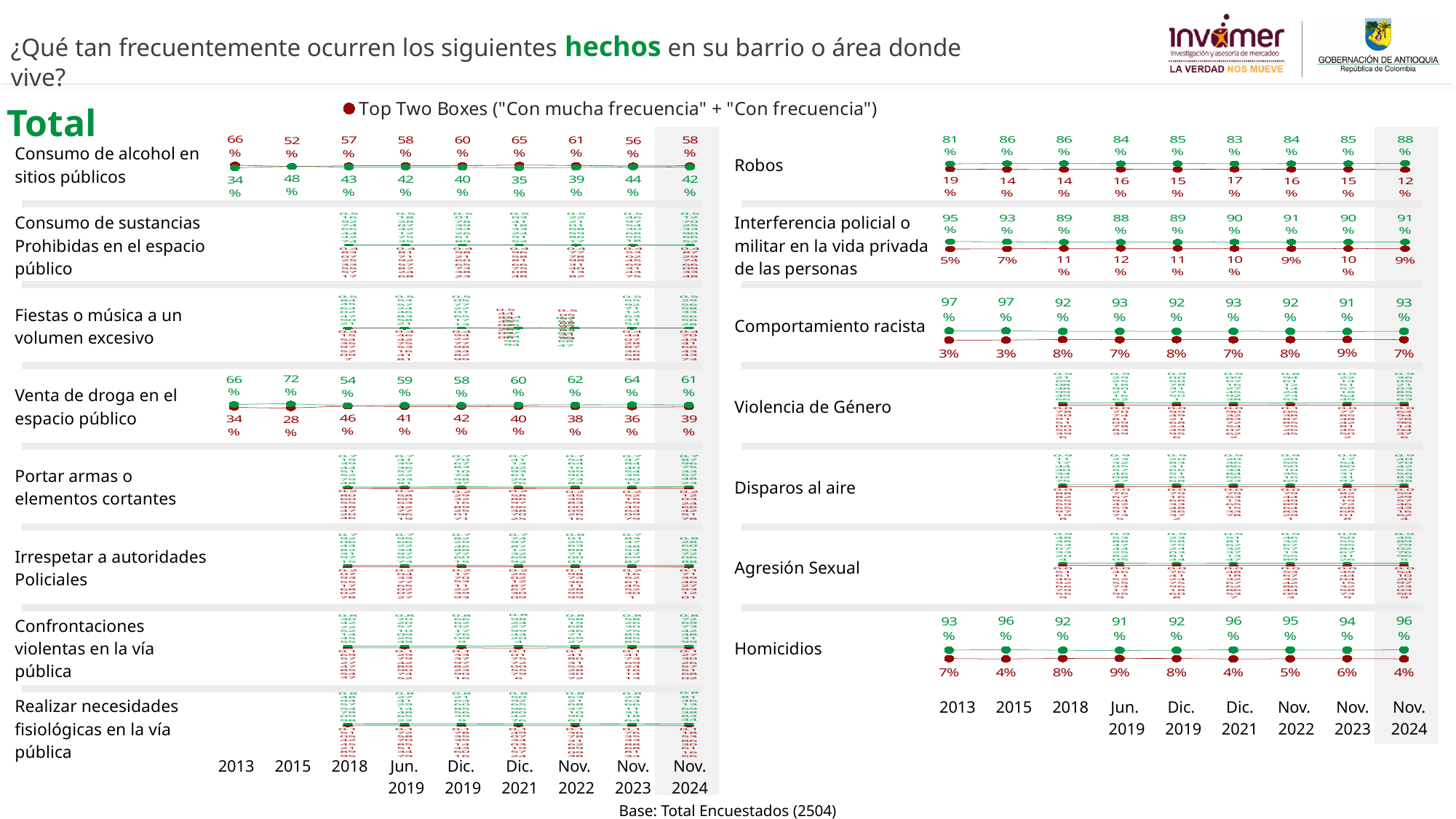
In the 'Venta de droga en el espacio público' chart, what is the red value for 2015? 28% In the 'Consumo de alcohol en sitios públicos' chart, what is the red (Top Two Boxes) value for Nov. 2024? 58% In the 'Interferencia policial o militar en la vida privada de las personas' chart, what is the red value for 2013? 5% In the 'Venta de droga en el espacio público' chart, in which period is the green value highest? 2015 In the 'Comportamiento racista' chart, in which period is the red value highest? Nov. 2023 In the 'Homicidios' chart, which is larger: the red value for Jun. 2019 or the red value for Nov. 2024? Jun. 2019 In the 'Consumo de alcohol en sitios públicos' chart, in which period is the red (Top Two Boxes) value highest? 2013 How many time periods are shown on the x axis of the 'Robos' chart? 9 In the 'Robos' chart, what is the red value for Nov. 2024? 12% What kind of chart is used for 'Consumo de alcohol en sitios públicos'? Line chart In the 'Robos' chart, what is the difference between the green value for Nov. 2024 and the green value for 2013? 7% In the 'Homicidios' chart, what is the green value for Nov. 2022? 95%